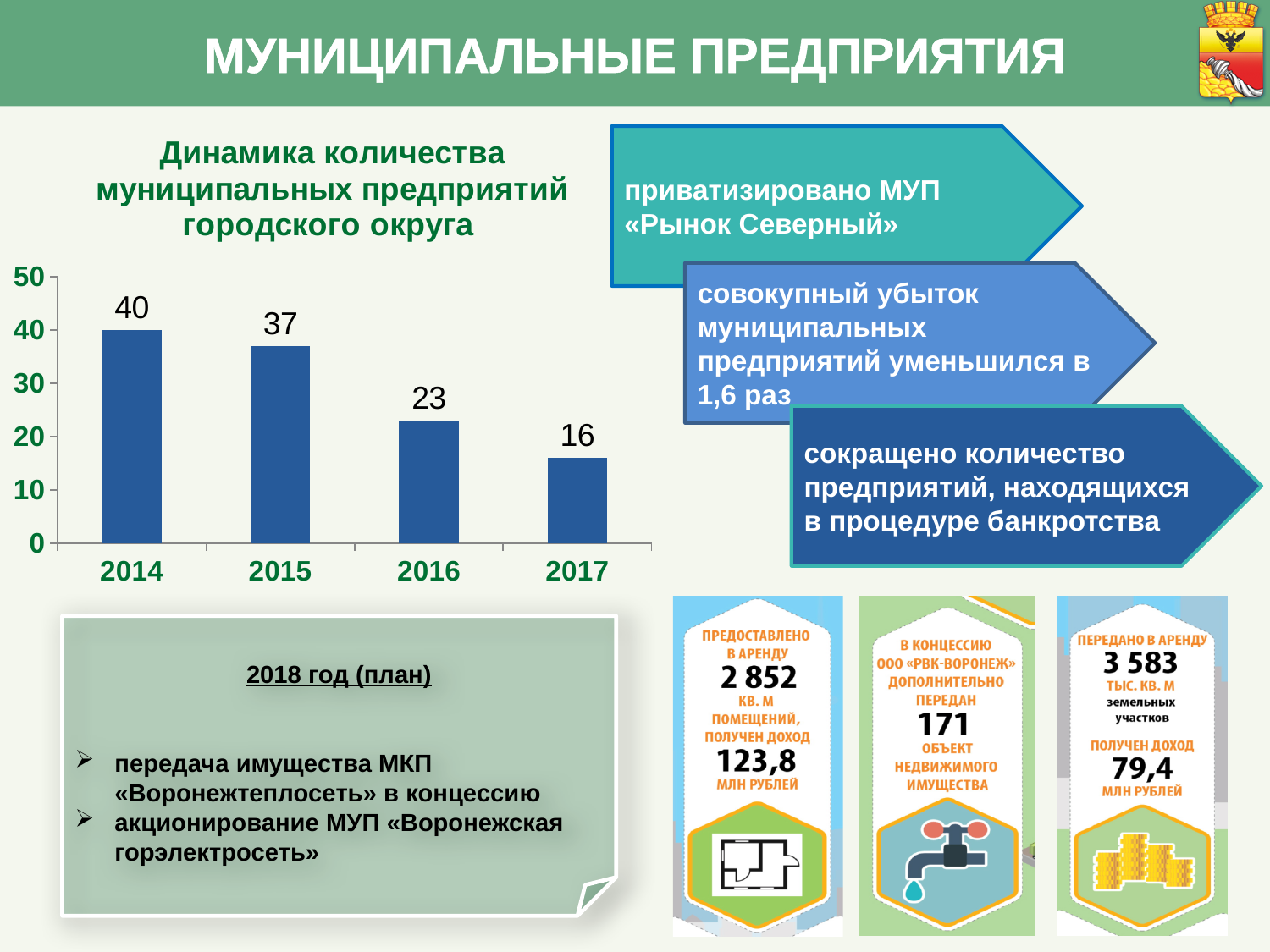
What is the difference between the values for 2015 and 2016? 14 What kind of chart is used to show the dynamics of the number of municipal enterprises? bar chart Which is larger, the value for 2015 or the value for 2016? 2015 What is the number of municipal enterprises shown for 2017? 16 What value is shown for 2016? 23 Is the value for 2016 greater or less than 30? less How many years are shown on the x axis of the chart? 4 What is the difference between the values for 2014 and 2017? 24 What is the number of municipal enterprises shown for 2014? 40 Do the values rise or fall from 2014 to 2017? fall Which year has the lowest number of municipal enterprises? 2017 Which year has the highest number of municipal enterprises? 2014